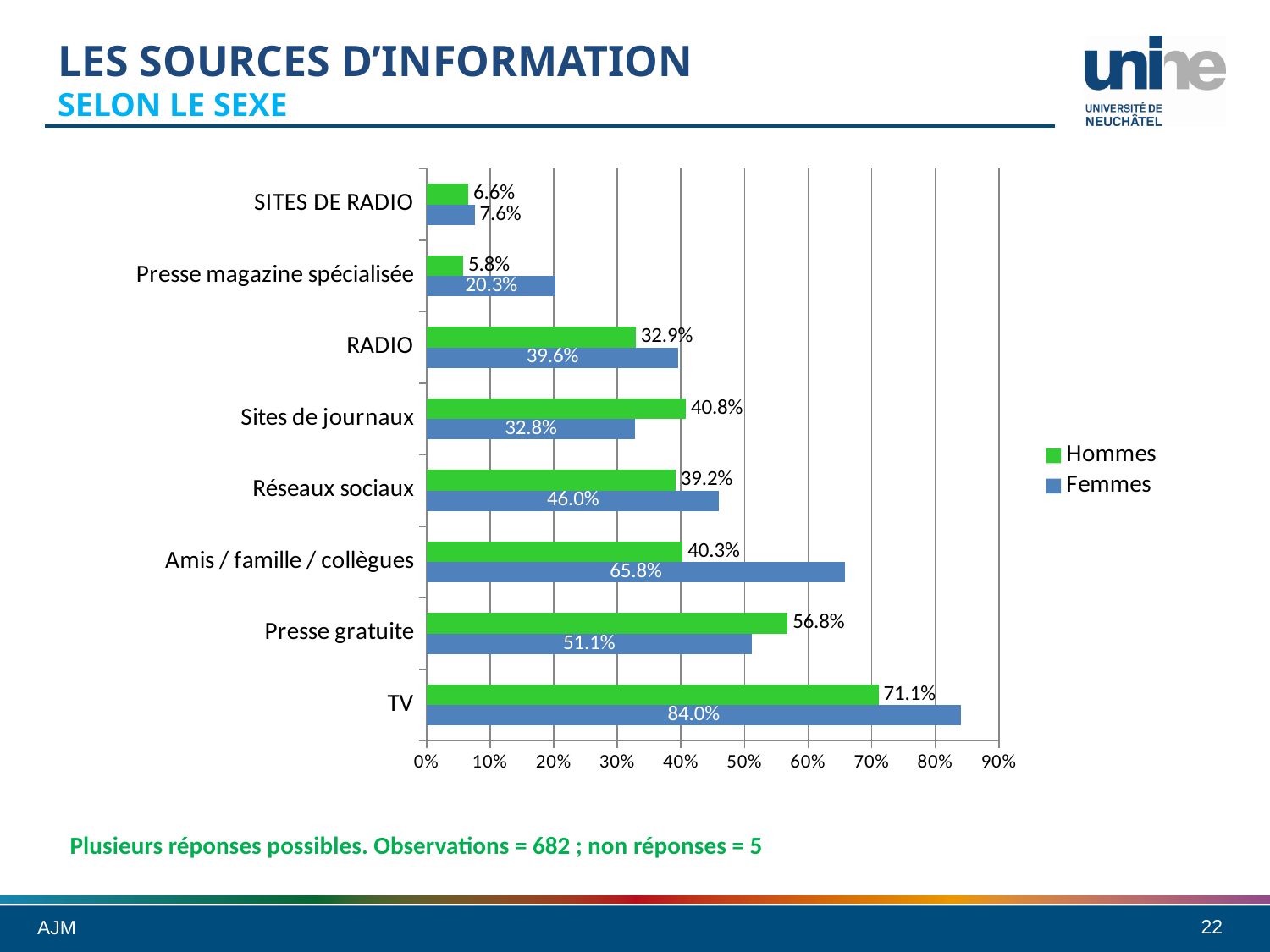
How many categories are shown on the chart? 8 What is the value for Hommes for Presse gratuite? 56.8% How many series does the legend list? 2 Which category has the highest value for Hommes? TV What is the value for Femmes for Presse magazine spécialisée? 20.3% What kind of chart is shown on the slide? bar chart Is the value for Femmes for Réseaux sociaux greater or less than 40%? greater Which is larger for Sites de journaux, the Hommes value or the Femmes value? Hommes Which category has the lowest value for Femmes? SITES DE RADIO What is the value for Femmes for TV? 84.0% What is the difference between the Femmes and Hommes values for Amis / famille / collègues? 25.5% Which colour represents Femmes in the chart? blue